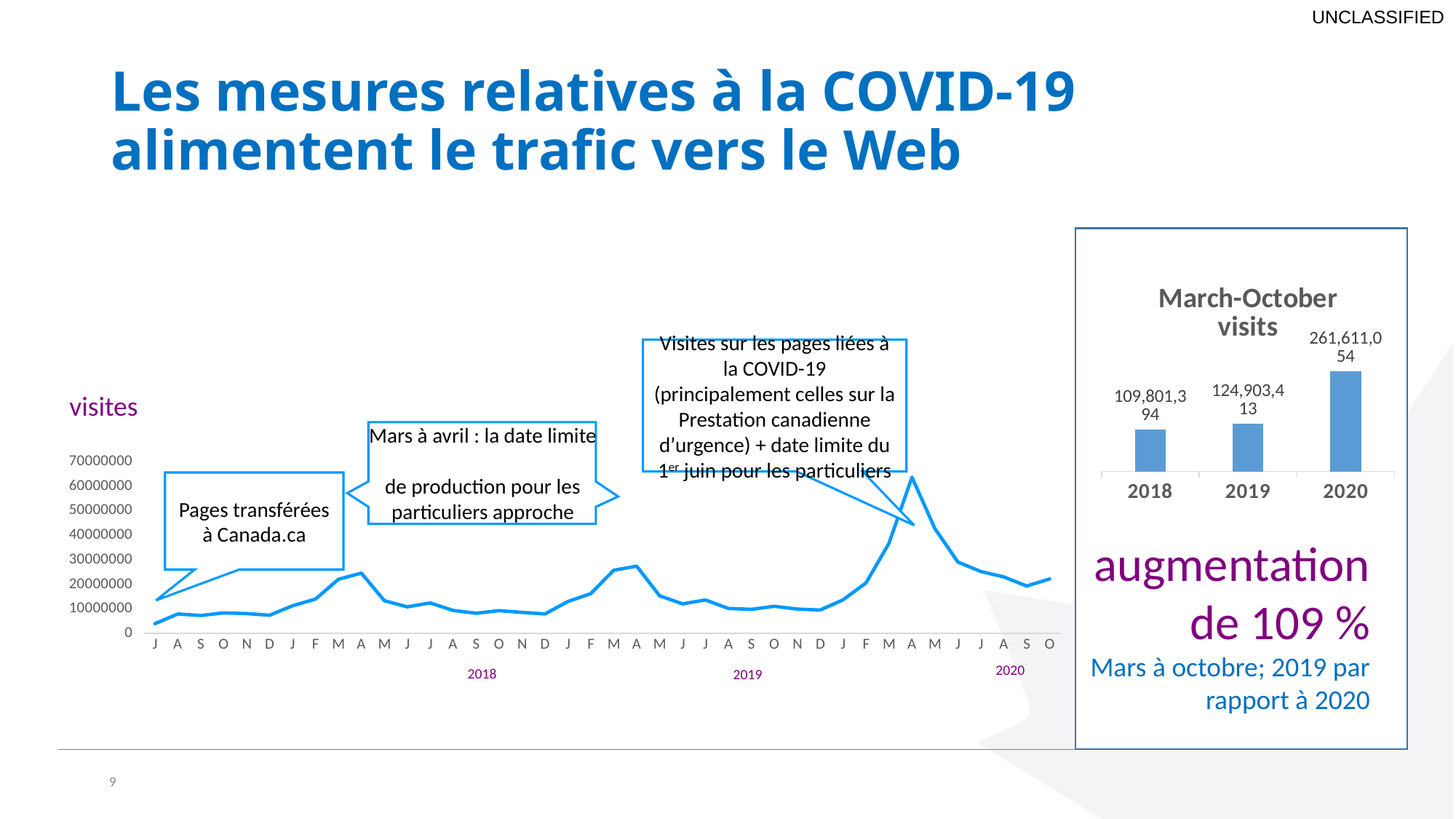
In the 'March-October visits' chart, what is the value for 2020? 261,611,054 In the 'March-October visits' chart, what is the value for 2018? 109,801,394 In the 'March-October visits' chart, which year has the lowest value? 2018 In the 'visites' line chart, do the values rise or fall from the April 2020 peak to October 2020? fall In the 'March-October visits' chart, which year has the highest value? 2020 In the 'visites' line chart, is the peak value in 2020 greater or less than 50000000? greater In the 'March-October visits' chart, what is the difference between the 2020 and 2019 values? 136,707,641 In the 'March-October visits' chart, how many years are shown? 3 In the 'March-October visits' chart, what is the difference between the 2019 and 2018 values? 15,102,019 What kind of chart is the 'March-October visits' chart? Bar chart What kind of chart is the 'visites' chart on the left? Line chart In the 'March-October visits' chart, what is the value for 2019? 124,903,413